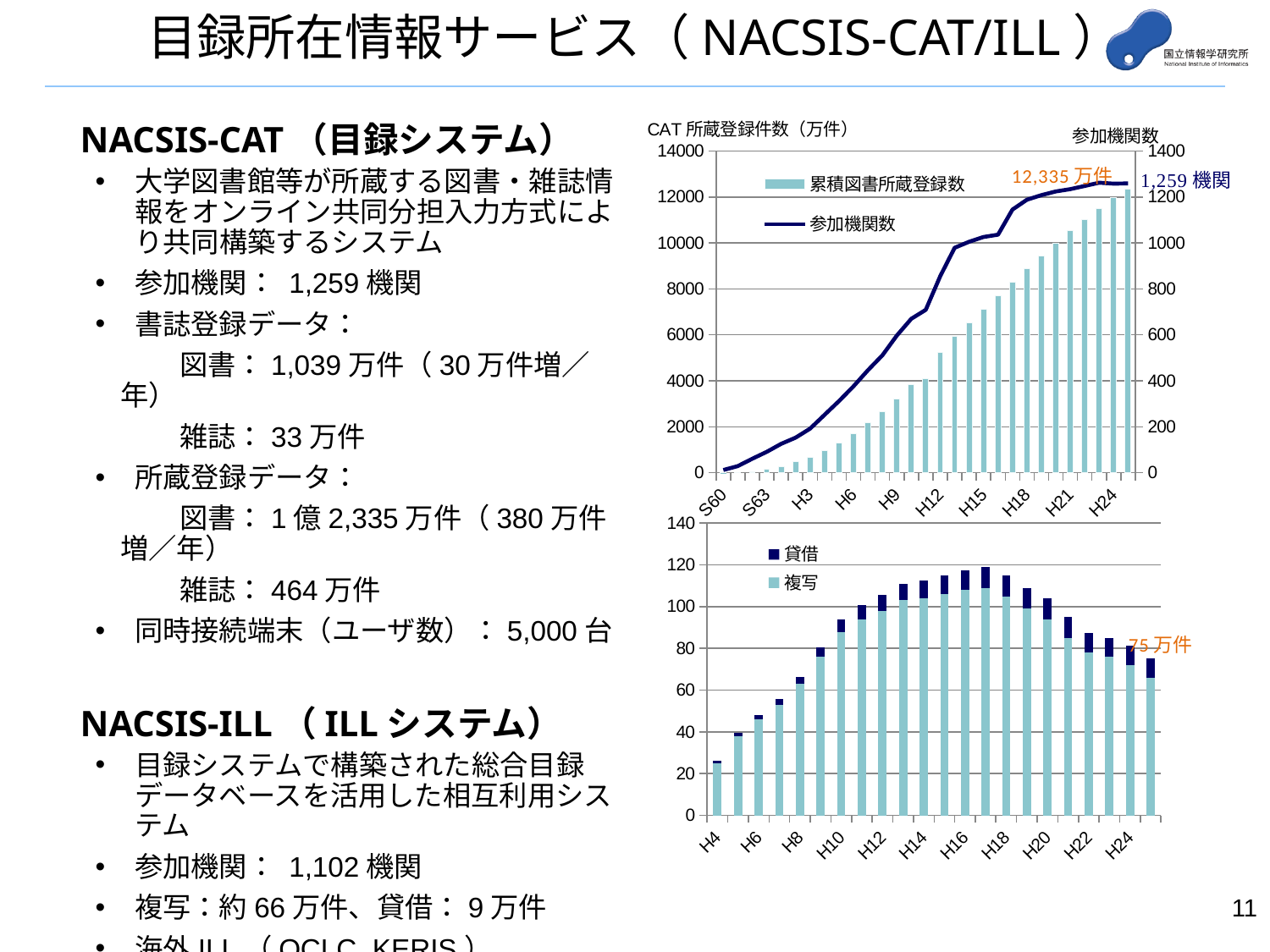
What kind of chart is the top chart (CAT 所蔵登録件数)? A bar chart combined with a line chart In the top chart, is the 参加機関数 line at H3 greater or less than 400? less What kind of chart is the bottom chart (貸借/複写)? A stacked bar chart In the top chart, is the 累積図書所蔵登録数 bar for H12 greater or less than 4000? greater In the top chart, what is the latest value of 参加機関数 shown by the data label? 1,259 機関 How many series does the legend of the top chart list? 2 In the top chart, what is the latest value of 累積図書所蔵登録数 shown by the data label? 12,335 万件 In the top chart, do the 累積図書所蔵登録数 bars rise or fall from S60 to H24? Rise How many series does the legend of the bottom chart list? 2 In the bottom chart, is the total bar for H16 greater or less than 100? greater What are the two legend entries in the top chart? 累積図書所蔵登録数 and 参加機関数 In the bottom chart, what total value is labelled on the last bar? 75 万件